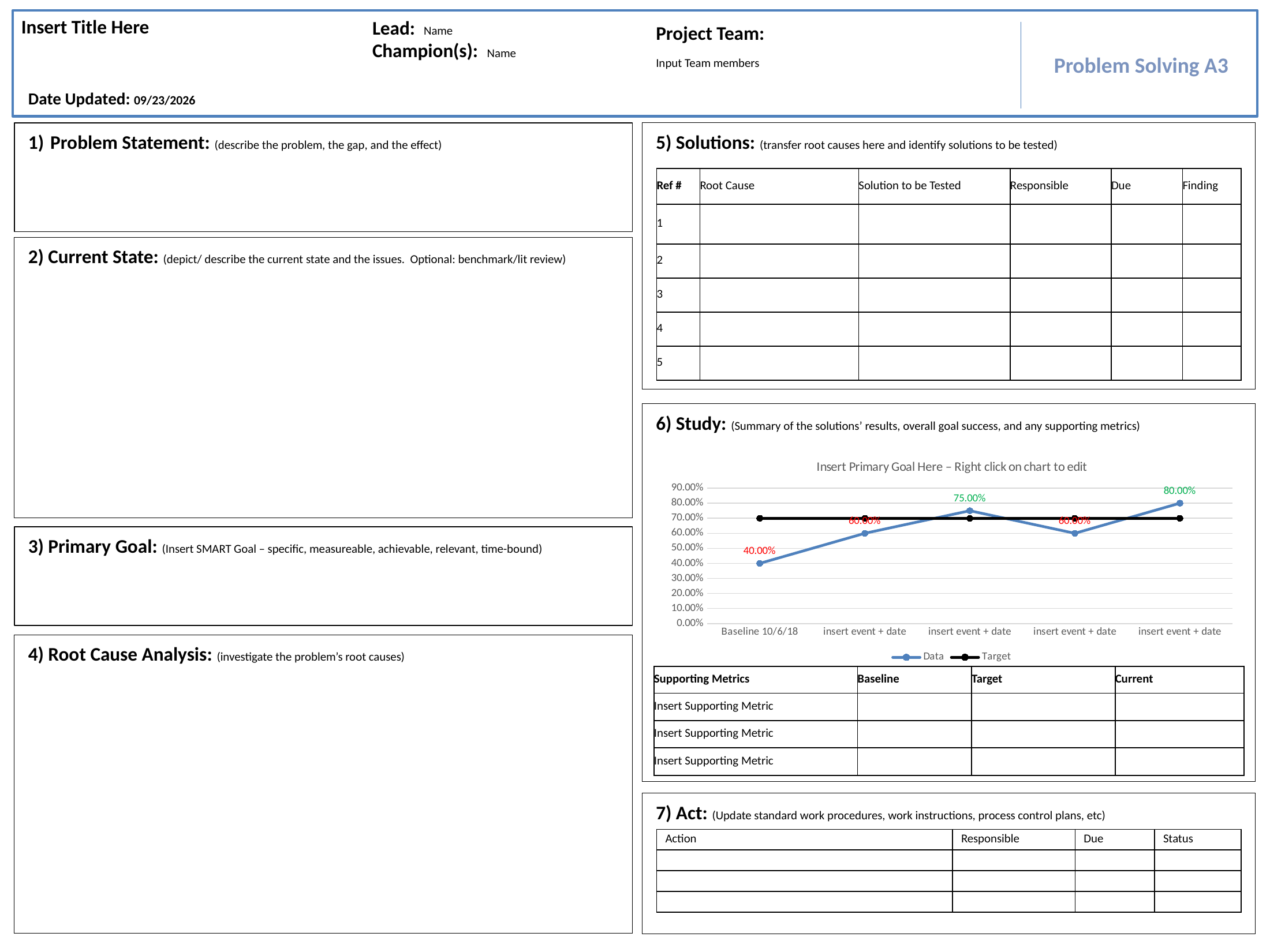
Is the Data value at Baseline 10/6/18 greater or less than 50.00%? less What is the title of the chart in the Study section? Insert Primary Goal Here – Right click on chart to edit How many series does the legend of the Study chart list? 2 What is the Data value at Baseline 10/6/18 in the Study chart? 40.00% How many data points are plotted on the Data series in the Study chart? 5 What is the difference between the highest and lowest Data values in the Study chart? 40.00% At Baseline 10/6/18, which is larger in the Study chart: the Data value or the Target value? Target What kind of chart is shown in the Study section? line chart Does the Data series in the Study chart generally rise or fall from the baseline to the last event? rise What are the two legend entries in the Study chart? Data and Target What is the highest labelled value on the Data series in the Study chart? 80.00% What is the lowest labelled value on the Data series in the Study chart? 40.00%